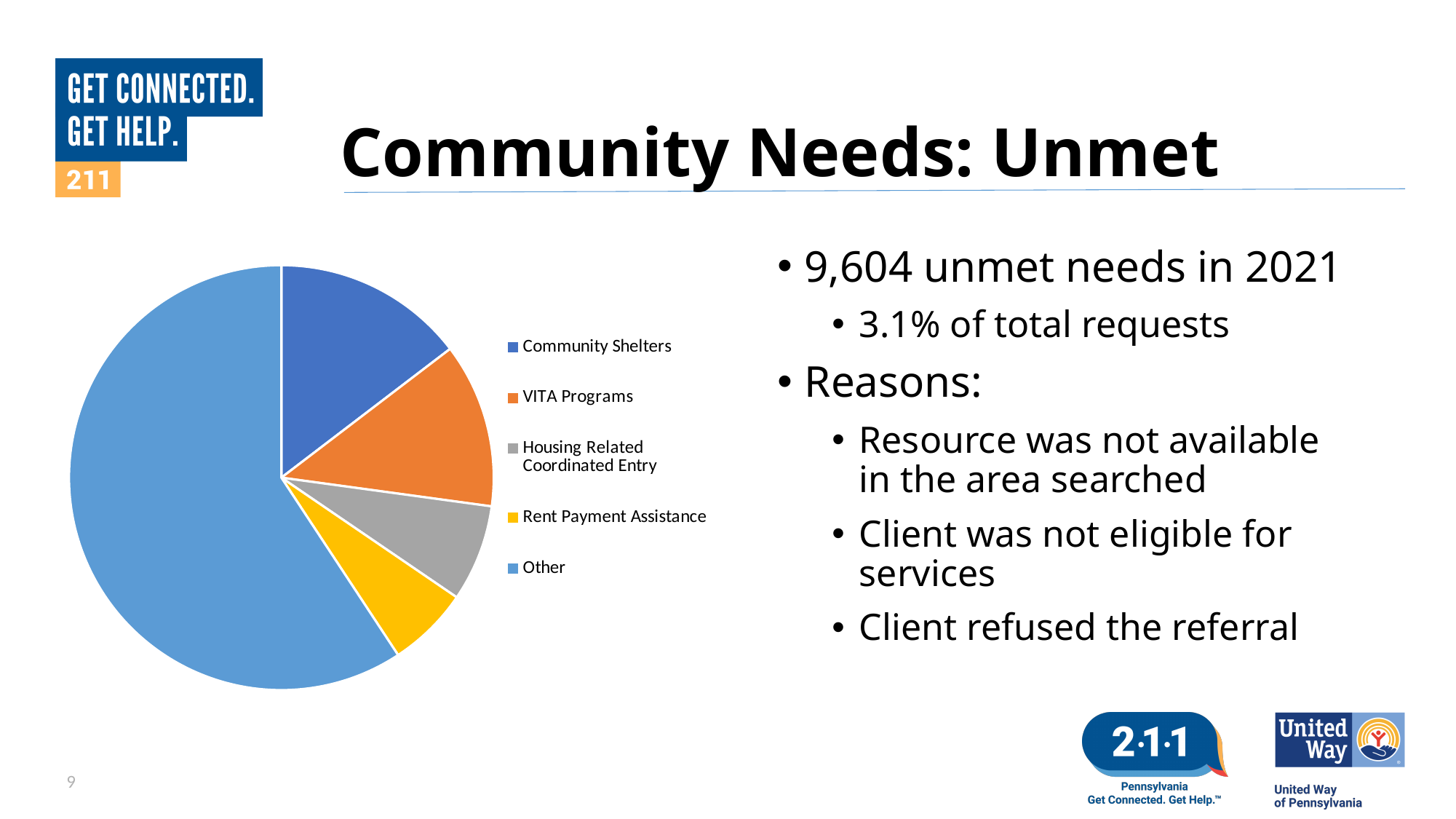
Which slice is larger in the pie chart, Other or VITA Programs? Other Which slice is larger in the pie chart, Community Shelters or Housing Related Coordinated Entry? Community Shelters Which category has the largest slice of the pie chart? Other How many categories does the pie chart's legend list? 5 What colour is the Rent Payment Assistance slice in the pie chart? yellow Which slice is larger in the pie chart, VITA Programs or Rent Payment Assistance? VITA Programs Which category in the pie chart's legend is shown in orange? VITA Programs What kind of chart is shown on the slide? pie chart